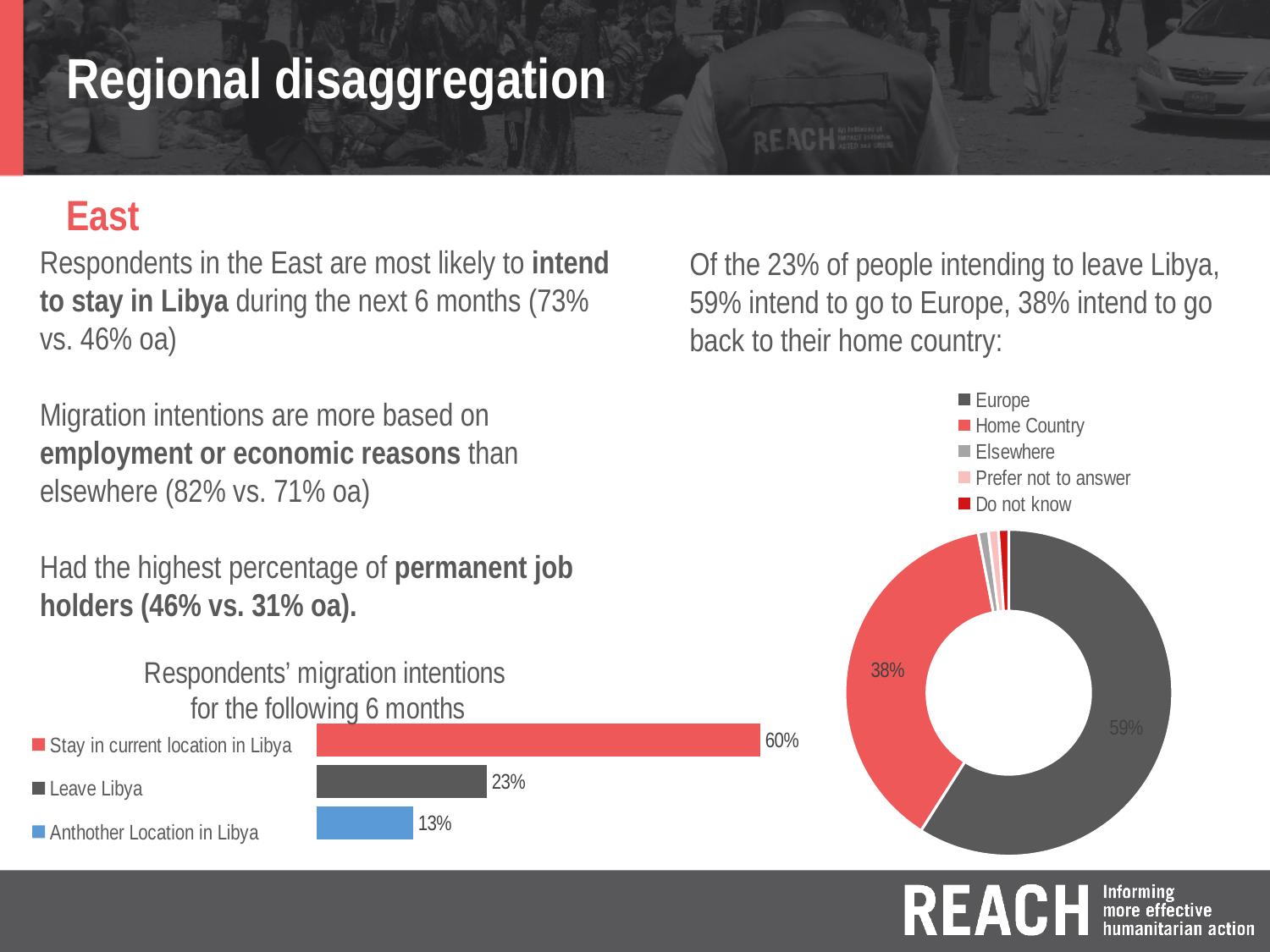
In the bar chart titled "Respondents' migration intentions for the following 6 months", what is the value for "Anthother Location in Libya"? 13% In the donut chart on the right of the slide, which is larger: Europe or Home Country? Europe In the bar chart titled "Respondents' migration intentions for the following 6 months", what is the value for "Leave Libya"? 23% In the donut chart on the right of the slide, what share of respondents intend to go to their Home Country? 38% In the bar chart titled "Respondents' migration intentions for the following 6 months", which category has the lowest value? Anthother Location in Libya In the bar chart titled "Respondents' migration intentions for the following 6 months", how many categories are shown? 3 In the donut chart on the right of the slide, what share of respondents intend to go to Europe? 59% How many entries does the legend of the donut chart on the right of the slide list? 5 In the bar chart titled "Respondents' migration intentions for the following 6 months", what is the difference between "Stay in current location in Libya" and "Leave Libya"? 37% What kind of chart is the chart titled "Respondents' migration intentions for the following 6 months"? Bar chart In the bar chart titled "Respondents' migration intentions for the following 6 months", what is the value for "Stay in current location in Libya"? 60% In the bar chart titled "Respondents' migration intentions for the following 6 months", which category has the highest value? Stay in current location in Libya